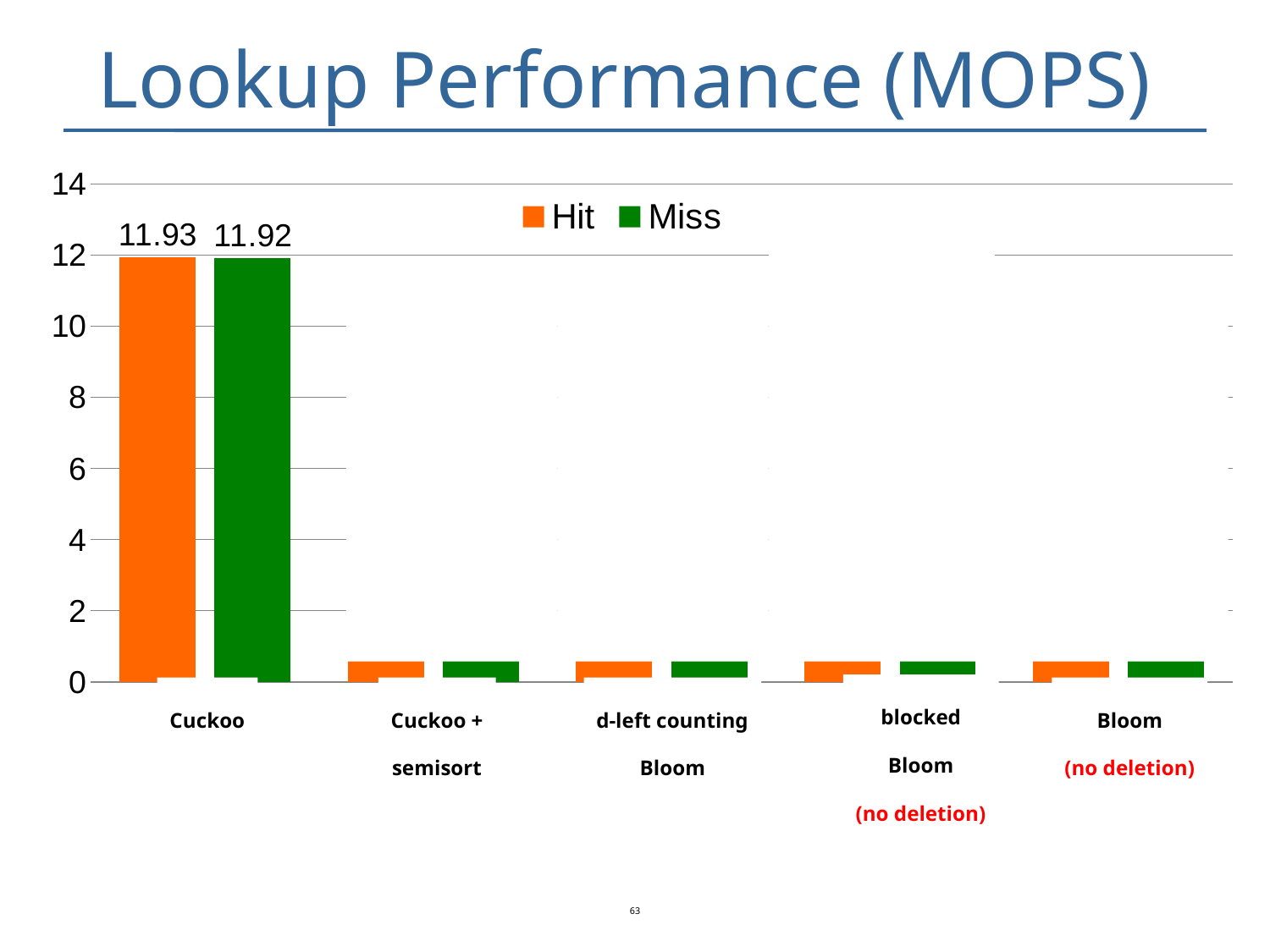
What is the Miss value for Cuckoo? 11.92 What is the title of the chart? Lookup Performance (MOPS) Is the Hit value for Cuckoo greater or less than 10? greater For Cuckoo, which is larger, the Hit value or the Miss value? Hit Is the Hit value for Cuckoo + semisort greater or less than 2? less What is the Hit value for Cuckoo? 11.93 How many categories are shown on the x axis? 5 How many series does the legend list? 2 Which category has the highest Hit value? Cuckoo What kind of chart is shown on the slide? bar chart Is the Miss value for Bloom (no deletion) greater or less than 2? less What is the difference between the Hit and Miss values for Cuckoo? 0.01